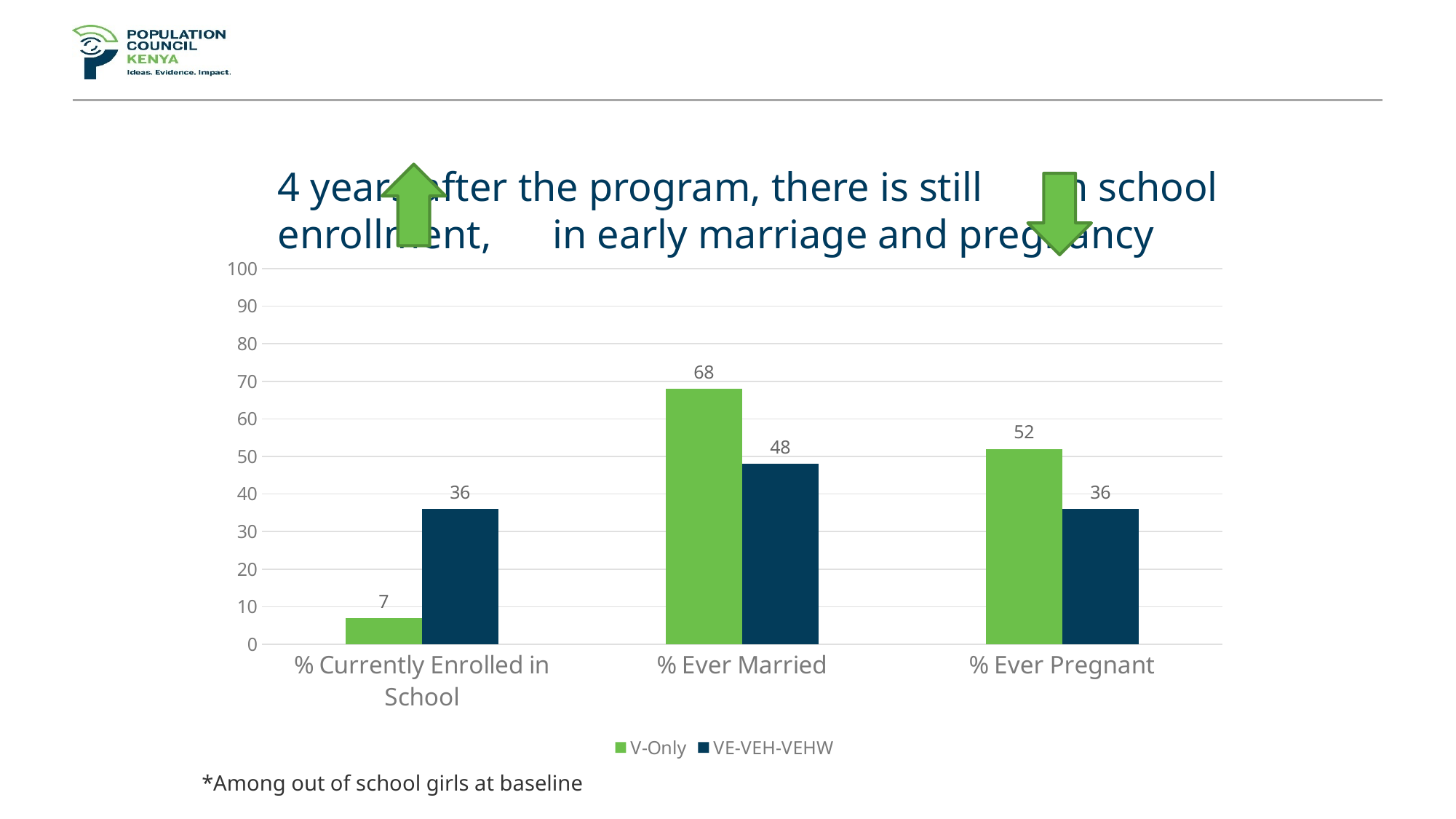
How many categories are shown on the x axis? 3 What colour are the V-Only bars? Green What is the VE-VEH-VEHW value for % Currently Enrolled in School? 36 What is the V-Only value for % Currently Enrolled in School? 7 For % Ever Pregnant, which series has the larger value, V-Only or VE-VEH-VEHW? V-Only How many series does the legend list? 2 What kind of chart is shown on the slide? Bar chart What is the V-Only value for % Ever Pregnant? 52 What is the VE-VEH-VEHW value for % Ever Married? 48 What is the difference between the V-Only and VE-VEH-VEHW values for % Ever Married? 20 Which category has the highest V-Only value? % Ever Married Which category has the lowest V-Only value? % Currently Enrolled in School